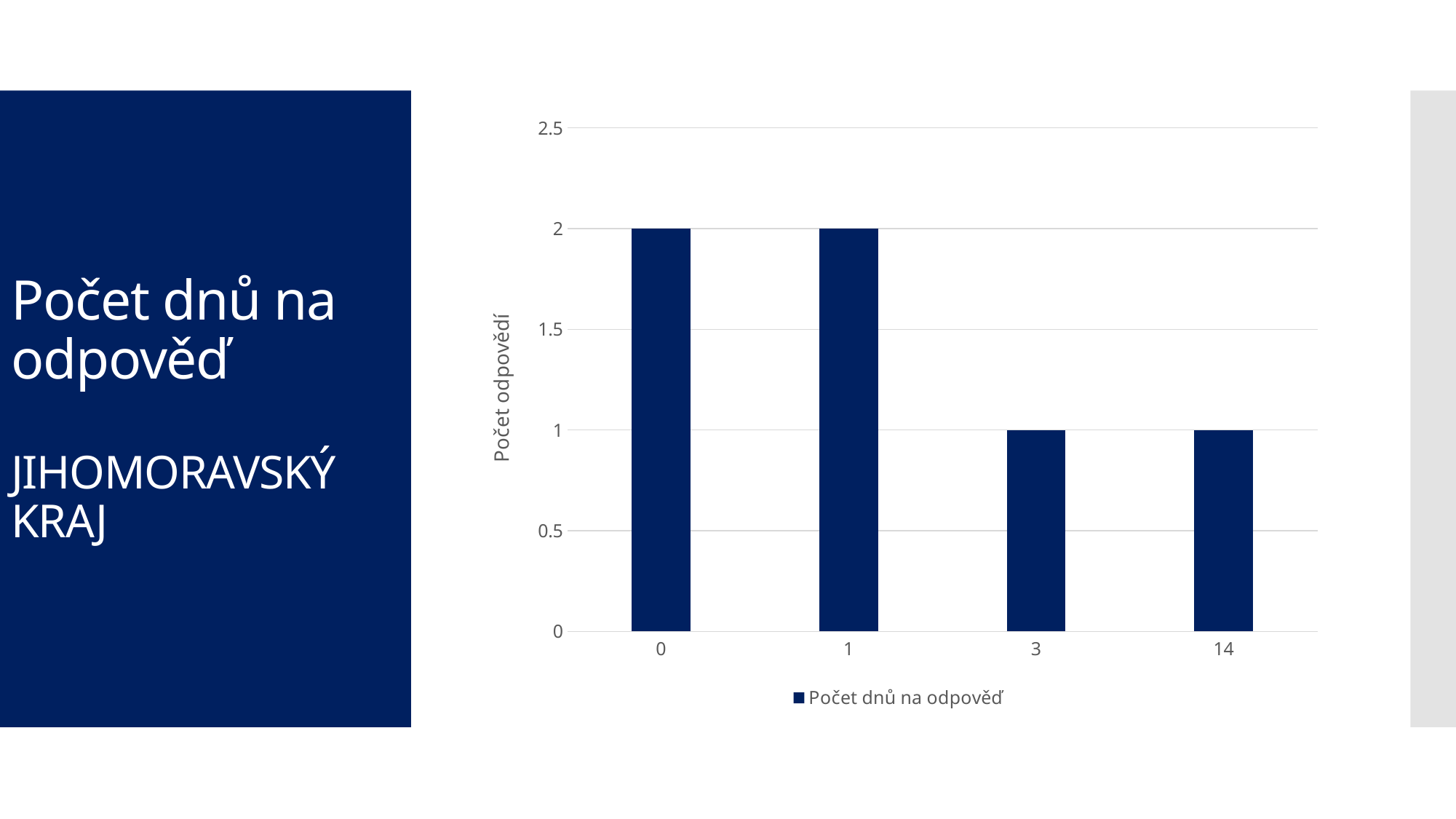
How many series does the chart legend list? 1 Which is larger, the value for category 0 or the value for category 3? 0 How many bars (categories) are plotted in the chart? 4 Is the value for category 14 greater or less than 1.5? less What is the number of responses for the category 1? 2 What is the label of the vertical axis? Počet odpovědí What is the number of responses (Počet odpovědí) for the category 0? 2 What is the number of responses for the category 14? 1 What is the difference between the value for category 1 and the value for category 14? 1 What series name is shown in the chart legend? Počet dnů na odpověď What type of chart is shown on the slide? bar chart What is the number of responses for the category 3? 1